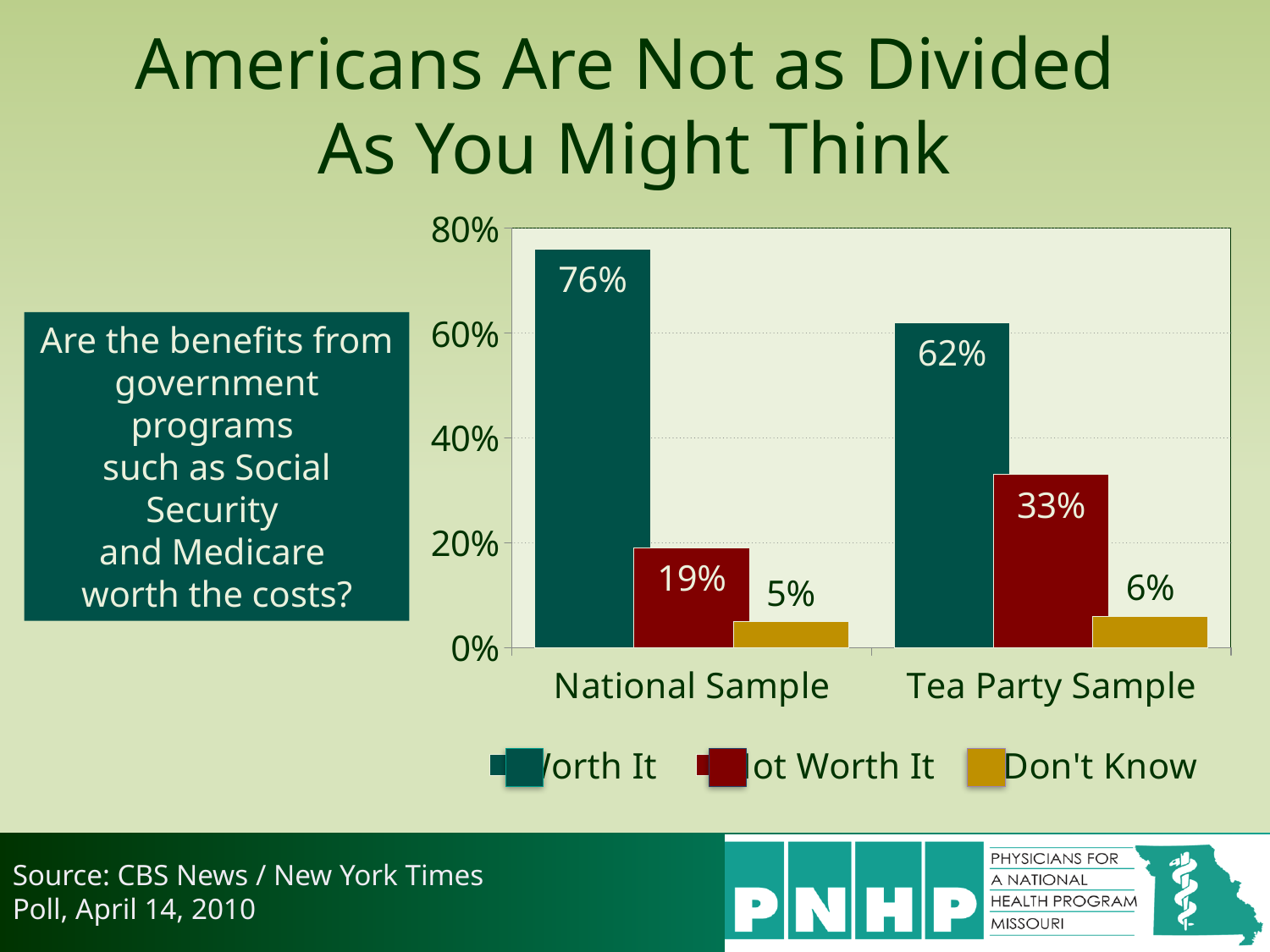
What is the Don't Know value for the Tea Party Sample? 6% What percentage of the National Sample said the benefits are Worth It? 76% What is the difference between the Worth It values for the National Sample and the Tea Party Sample? 14% What percentage of the Tea Party Sample said the benefits are Not Worth It? 33% How many sample categories are shown on the x axis? 2 Which response has the lowest value in the National Sample? Don't Know Which sample has the higher Worth It percentage? National Sample What kind of chart is shown on the slide? bar chart How many series does the legend list? 3 What is the difference between the Not Worth It values for the Tea Party Sample and the National Sample? 14% What is the Not Worth It value for the National Sample? 19% Is the Worth It value for the Tea Party Sample larger or smaller than the Not Worth It value for the Tea Party Sample? larger